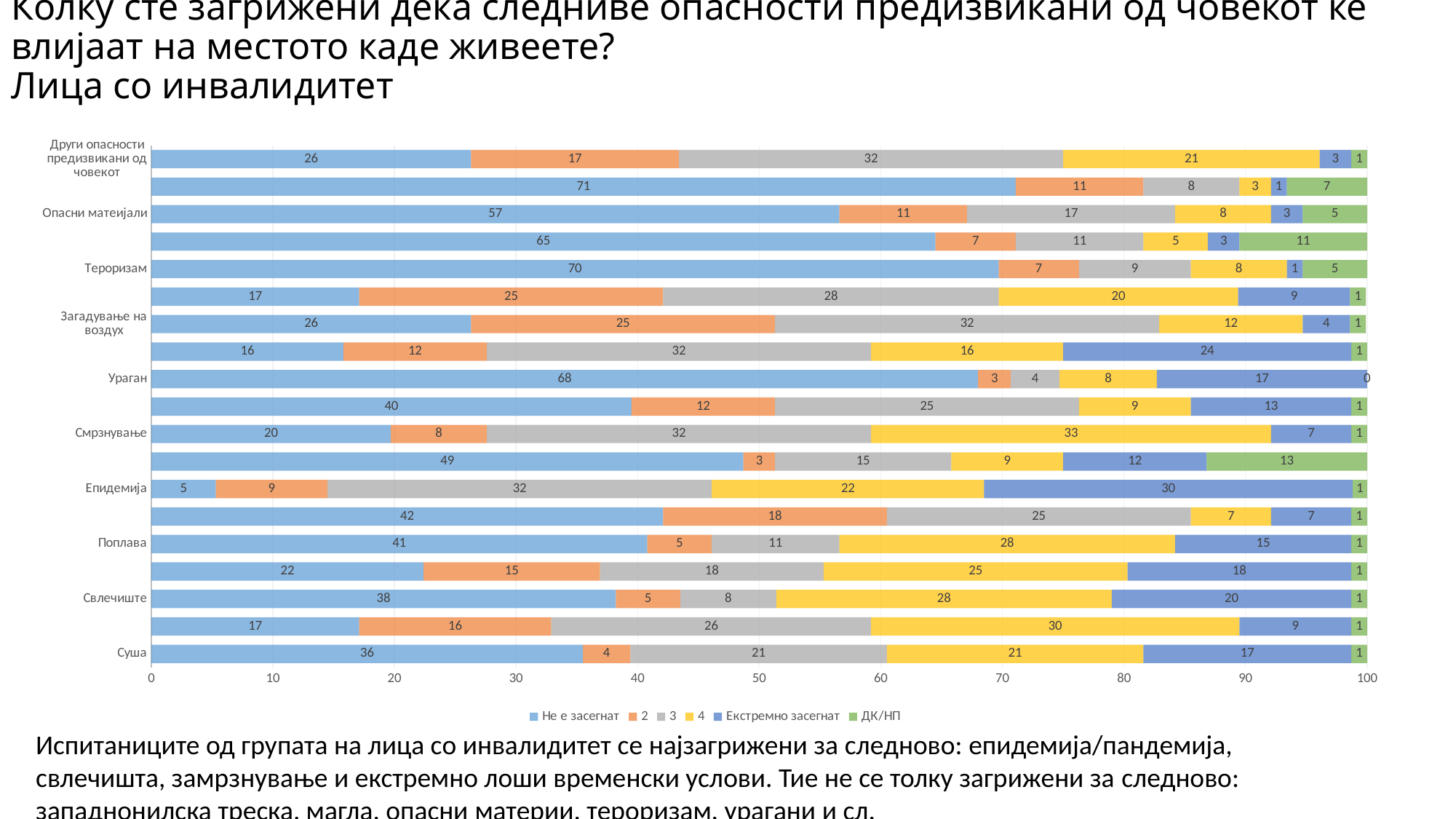
What is the total of the stacked bar for Ураган? 100 What is the value of the 'ДК/НП' segment for Опасни матеијали? 5 What is the first entry in the chart legend? Не е засегнат How many series does the legend list? 6 What is the value of the 'Не е засегнат' segment for Тероризам? 70 What is the value of the 'Екстремно засегнат' segment for Епидемија? 30 What kind of chart is shown on the slide? Stacked bar chart For Свлечиште, what is the difference between the '4' segment and the '2' segment? 23 What is the value of the '4' segment for Смрзнување? 33 Which has a larger 'Не е засегнат' value, Поплава or Суша? Поплава Which category has the lowest 'Не е засегнат' value? Епидемија Which category has the highest 'Екстремно засегнат' value? Епидемија